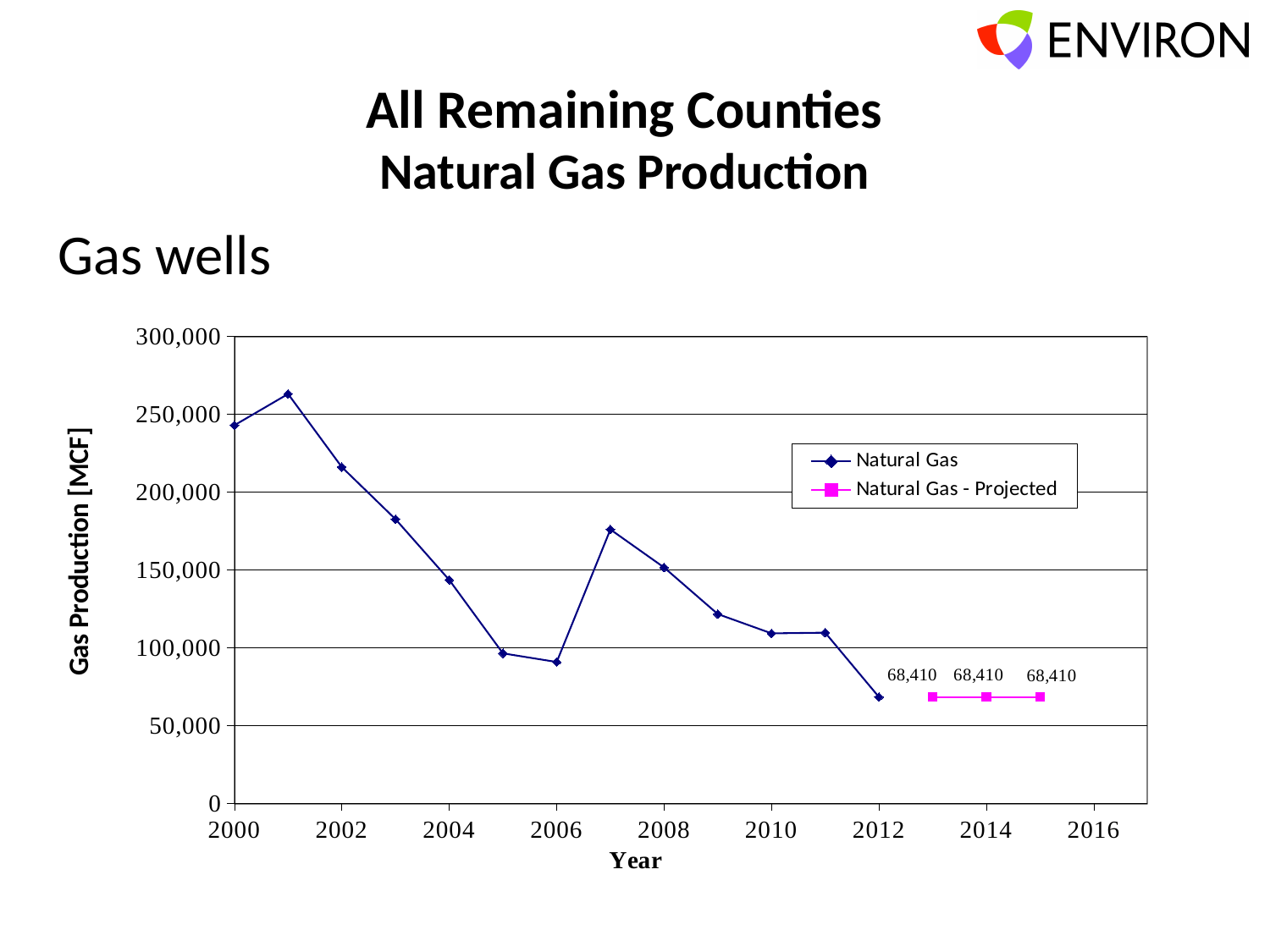
How many data points are plotted for the Natural Gas series? 13 In which year is the Natural Gas series at its highest? 2001 How many series does the legend list? 2 Is the Natural Gas value for 2001 greater or less than 250,000? greater Which year has the larger Natural Gas value, 2007 or 2008? 2007 What is the label of the y axis? Gas Production [MCF] What type of chart is shown on the slide? Line chart Is the Natural Gas value for 2006 greater or less than 100,000? less In which year is the Natural Gas series at its lowest? 2012 What is the projected natural gas production value for 2015? 68,410 What is the projected natural gas production value for 2014? 68,410 How many data points are plotted for the Natural Gas - Projected series? 3